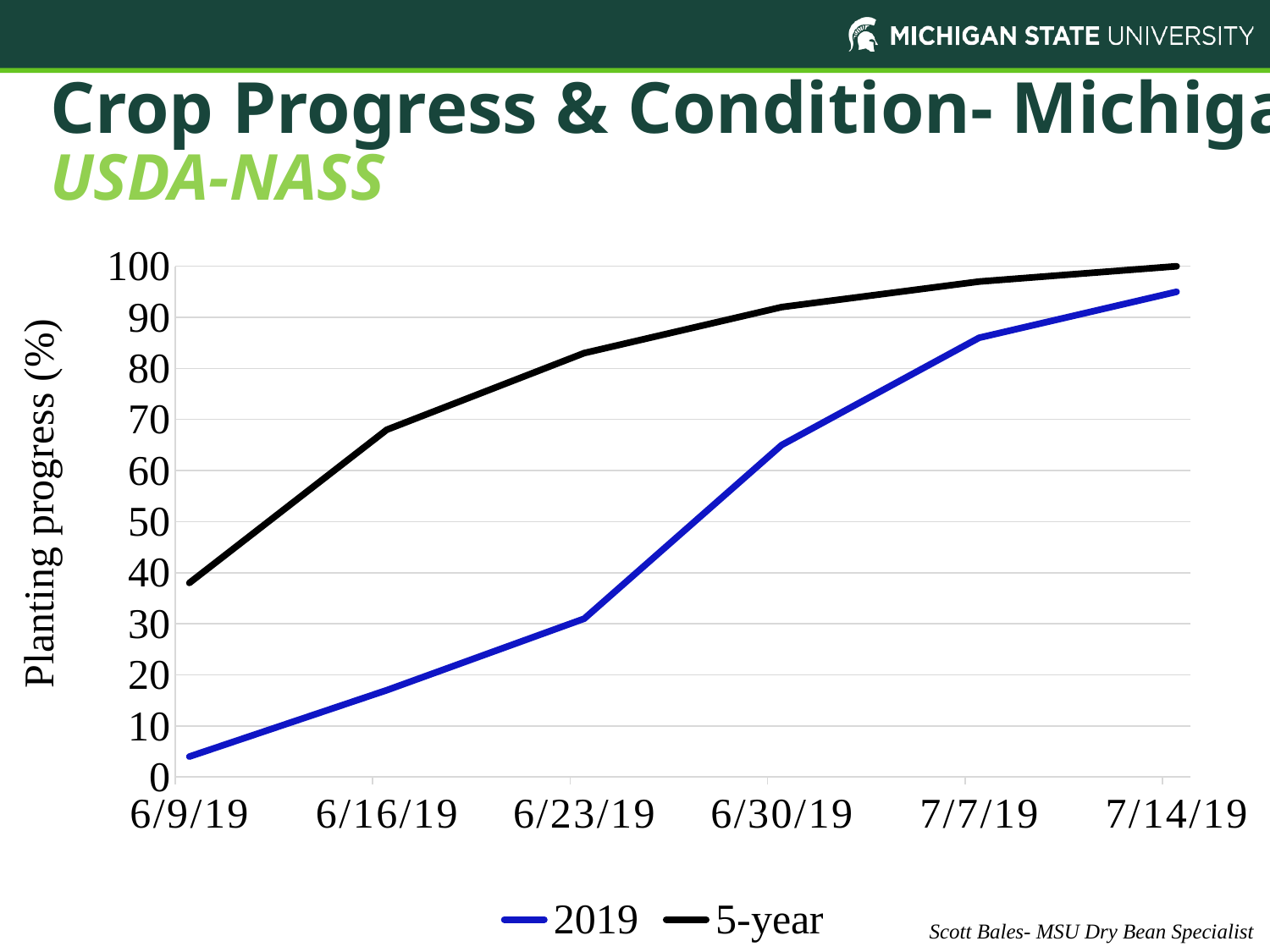
How many series does the legend list? 2 Is the 2019 planting progress on 6/23/19 greater or less than 40? less Is the 5-year planting progress on 6/9/19 greater or less than 30? greater On which date is the 2019 planting progress lowest? 6/9/19 What kind of chart is shown on the slide? line chart Is the 2019 planting progress on 6/30/19 greater or less than 60? greater On 6/30/19, which series shows higher planting progress, 2019 or 5-year? 5-year What is the label of the y axis? Planting progress (%) How many dates are plotted along the x axis? 6 Do the 2019 planting progress values rise or fall from 6/9/19 to 7/14/19? rise